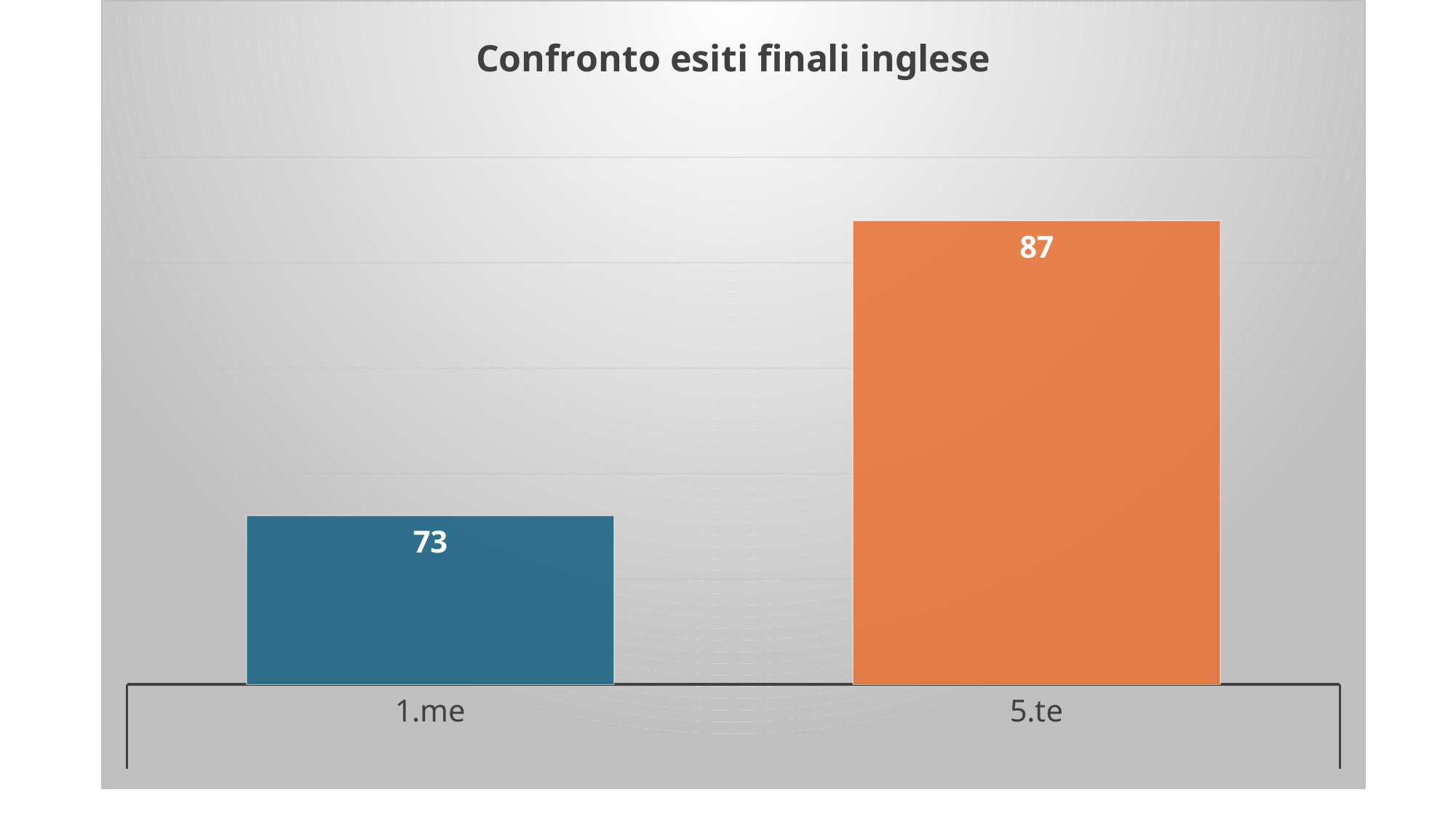
What is the difference between the values for 5.te and 1.me? 14 How many categories are shown in the chart? 2 What is the value for 5.te? 87 What colour is the bar for 5.te? orange Which category has the lowest value? 1.me Which is larger, the value for 1.me or the value for 5.te? 5.te Do the values rise or fall from 1.me to 5.te? rise What is the title of the chart? Confronto esiti finali inglese Which category has the highest value? 5.te What is the value for 1.me? 73 What kind of chart is shown on the slide? bar chart